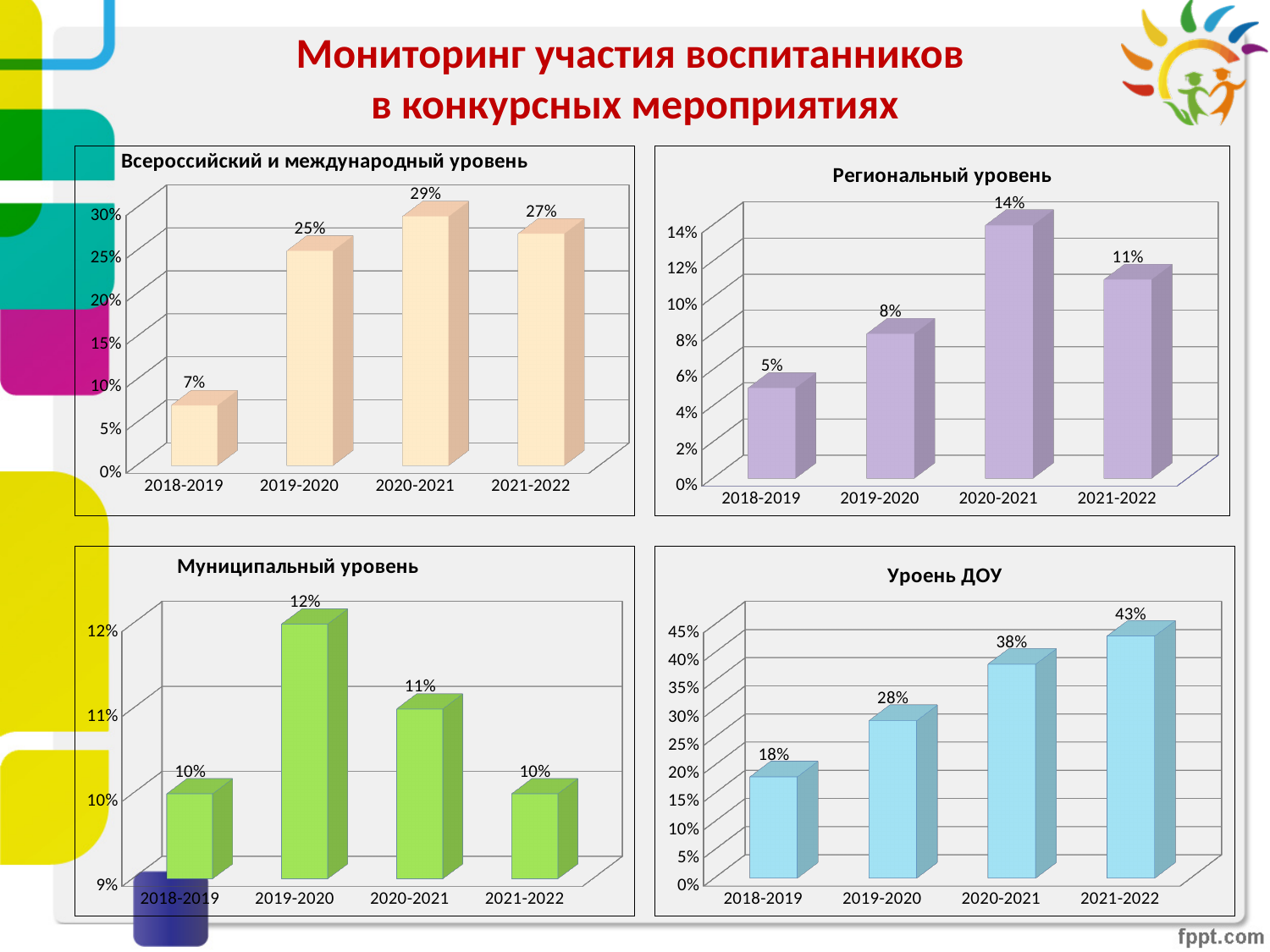
In the chart titled "Уроень ДОУ", what is the difference between the values for 2021-2022 and 2019-2020? 15% In the chart titled "Всероссийский и международный уровень", what is the value for 2020-2021? 29% In the chart titled "Уроень ДОУ", what is the value for 2018-2019? 18% In the chart titled "Региональный уровень", what is the value for 2021-2022? 11% In the chart titled "Региональный уровень", what is the difference between the values for 2020-2021 and 2018-2019? 9% In the chart titled "Региональный уровень", which year has the highest value? 2020-2021 What kind of chart is the chart titled "Региональный уровень"? bar chart In the chart titled "Муниципальный уровень", what is the value for 2019-2020? 12% In the chart titled "Муниципальный уровень", which is larger, the value for 2019-2020 or the value for 2020-2021? 2019-2020 In the chart titled "Уроень ДОУ", do the values rise or fall from 2018-2019 to 2021-2022? rise In the chart titled "Всероссийский и международный уровень", which year has the lowest value? 2018-2019 How many categories are shown on the x axis of the chart titled "Всероссийский и международный уровень"? 4